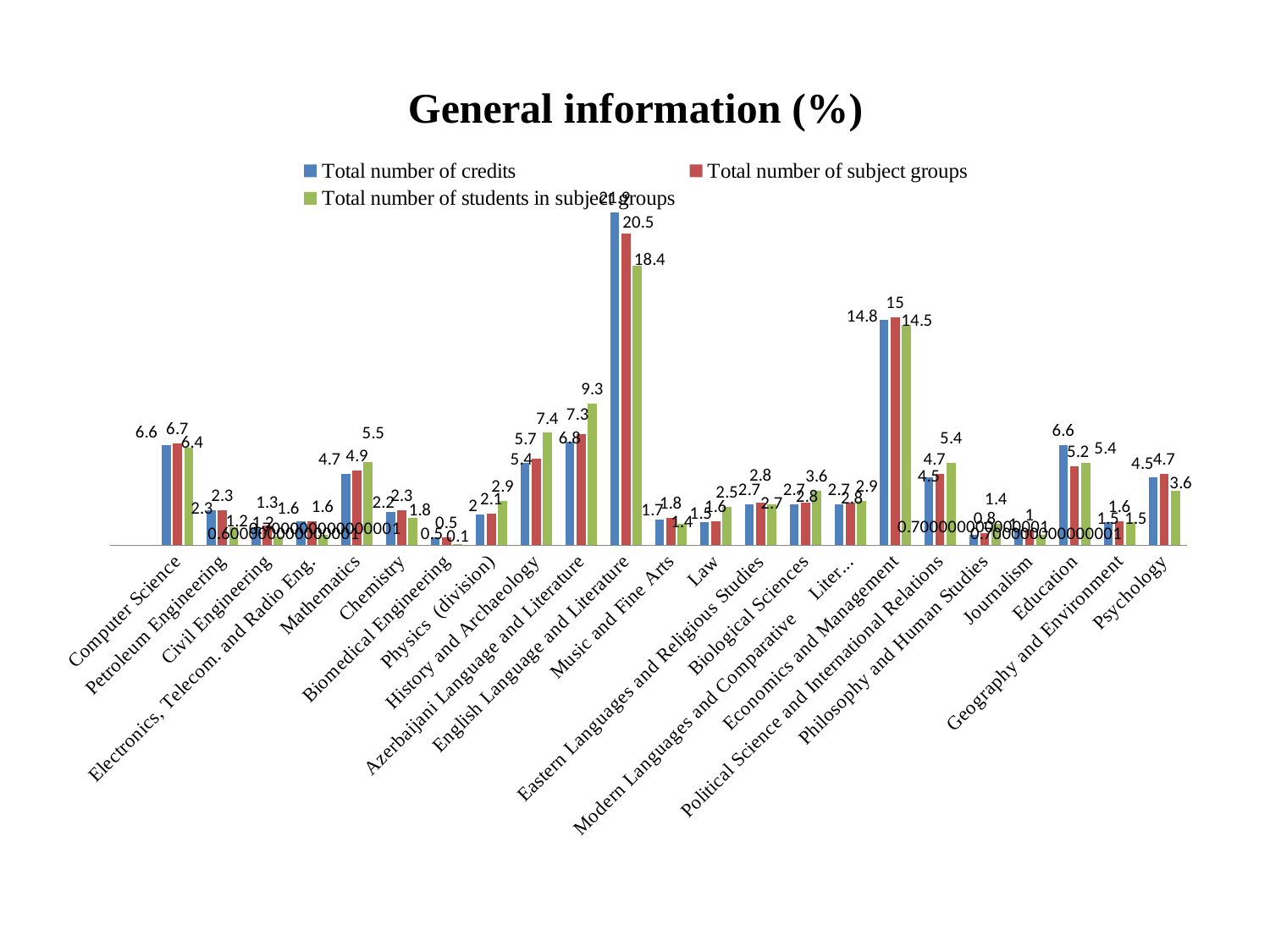
What is the title of the chart? General information (%) What is the value for Total number of students in subject groups for Mathematics? 5.5 What is the value for Total number of students in subject groups for Azerbaijani Language and Literature? 9.3 What kind of chart is shown on the slide? Bar chart How many series does the legend list? 3 What is the difference between Total number of credits and Total number of students in subject groups for English Language and Literature? 3.5 Which category has the highest value for Total number of credits? English Language and Literature What is the value for Total number of credits for Education? 6.6 How many categories are shown on the x axis? 23 What is the value for Total number of subject groups for Economics and Management? 15 What is the value for Total number of credits for English Language and Literature? 21.9 For Education, which is larger: Total number of credits or Total number of subject groups? Total number of credits